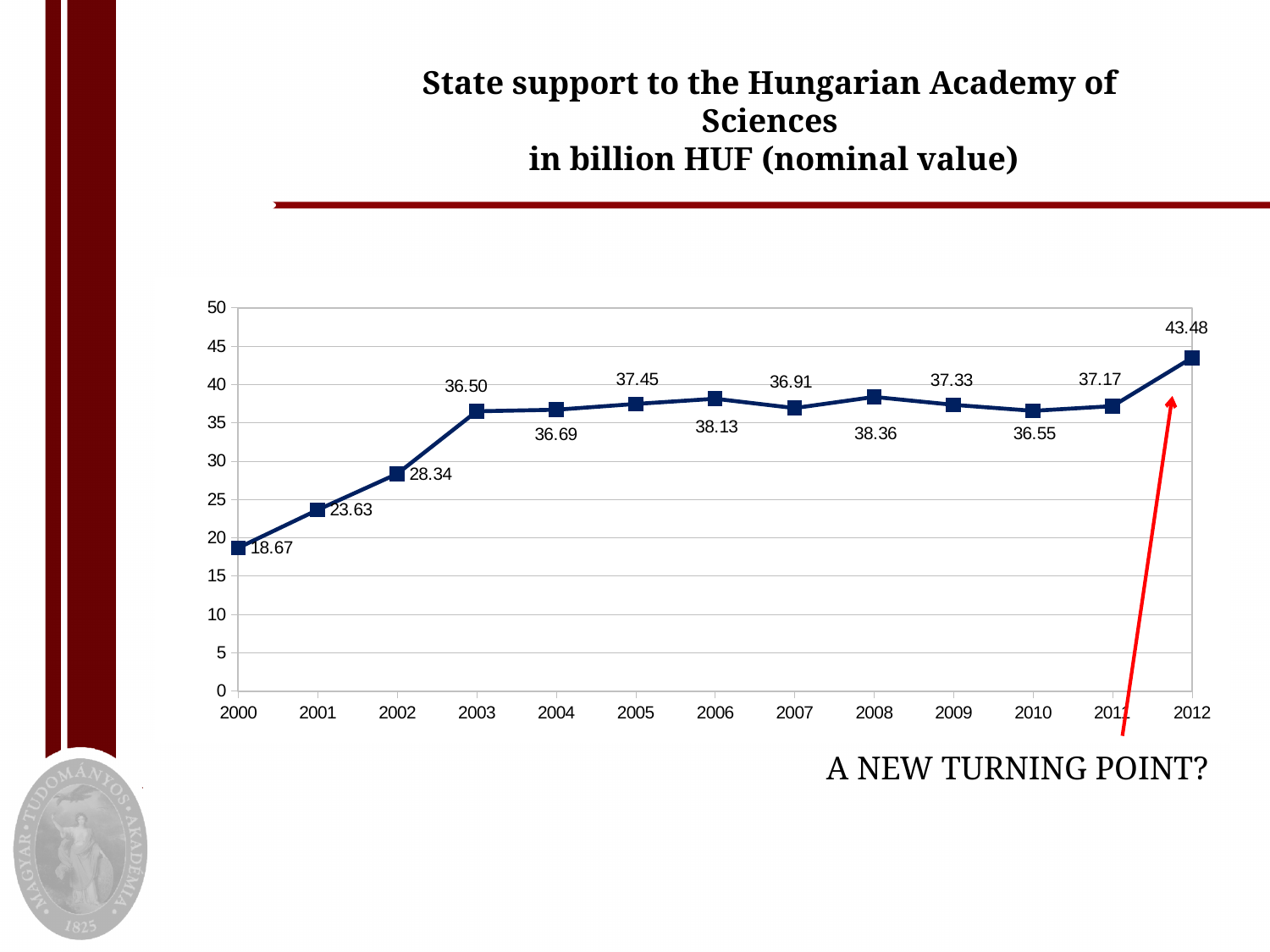
What unit is the state support measured in, according to the chart title? billion HUF (nominal value) What value is shown for 2012? 43.48 What is the difference between the values for 2012 and 2011? 6.31 Which year has the lowest value? 2000 What kind of chart is shown on the slide? line chart How many years are plotted on the chart? 13 Does the value rise or fall from 2000 to 2003? rise What was the state support to the Hungarian Academy of Sciences in 2000? 18.67 Which year has the larger value, 2008 or 2010? 2008 What is the difference between the values for 2003 and 2002? 8.16 What value is shown for 2006? 38.13 Which year has the highest value? 2012